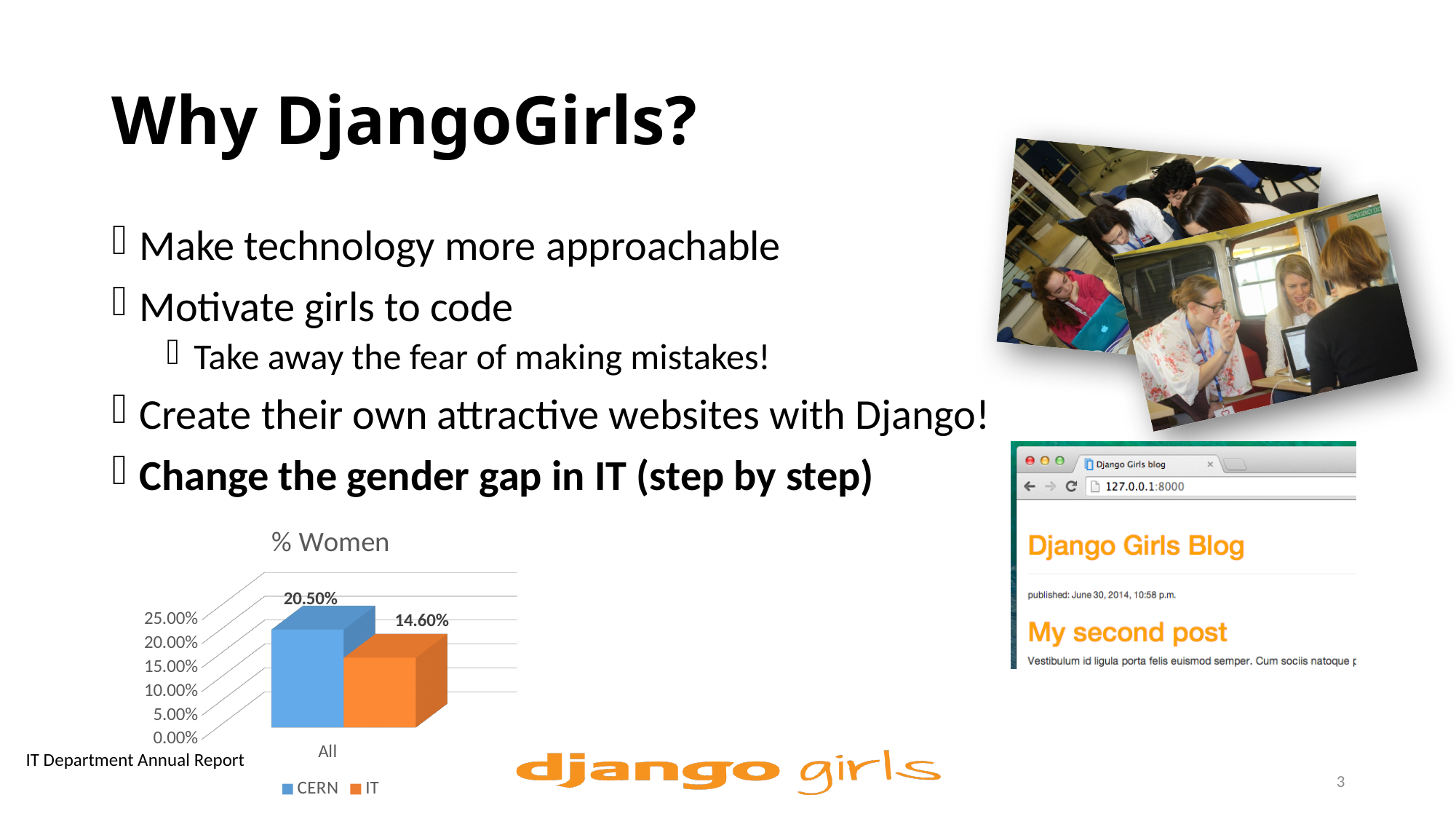
What is the title of the chart on the slide? % Women Is the value for CERN in the % Women chart greater or less than 20.00%? greater Which series has the lowest value in the % Women chart? IT What is the difference between the CERN and IT values in the % Women chart? 5.90% How many series does the legend of the % Women chart list? 2 How many categories are shown on the x axis of the % Women chart? 1 What is the value for CERN in the % Women chart? 20.50% Is the value for IT in the % Women chart greater or less than 15.00%? less Which series has the higher value in the % Women chart, CERN or IT? CERN What is the label of the category on the x axis of the % Women chart? All What is the value for IT in the % Women chart? 14.60% What kind of chart is the % Women chart? bar chart